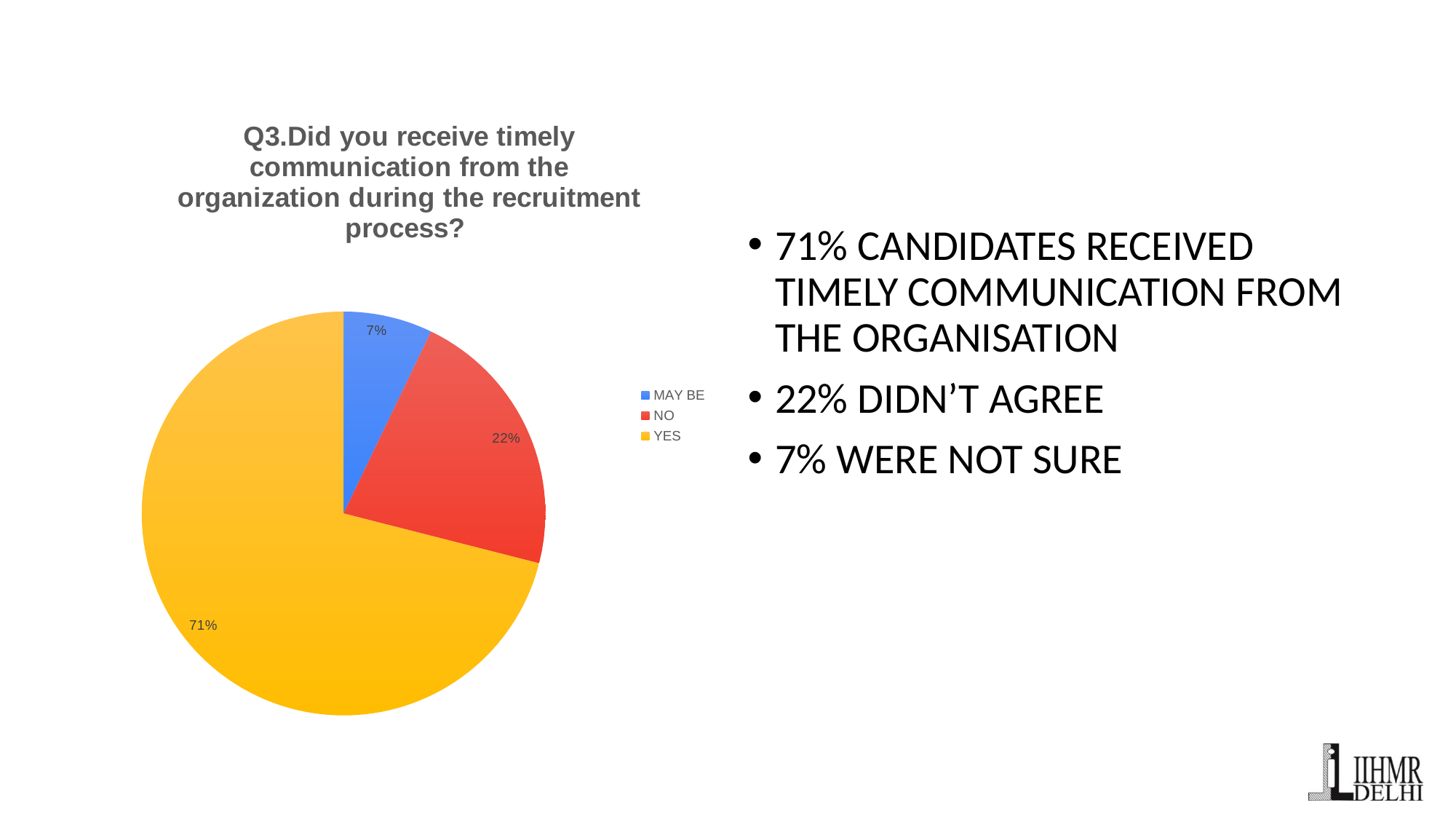
What kind of chart is shown on the slide? Pie chart Which category has the largest slice of the pie? YES How many categories does the pie chart have? 3 What colour is the YES slice in the pie chart? Yellow What is the difference in percentage points between the NO slice and the MAY BE slice? 15 Which slice is larger, NO or MAY BE? NO Which category has the smallest slice of the pie? MAY BE What is the title of the pie chart? Q3.Did you receive timely communication from the organization during the recruitment process? What percentage of the pie is labelled MAY BE? 7% What is the difference in percentage points between the YES slice and the NO slice? 49 What percentage of the pie is labelled NO? 22% What percentage of the pie is labelled YES? 71%